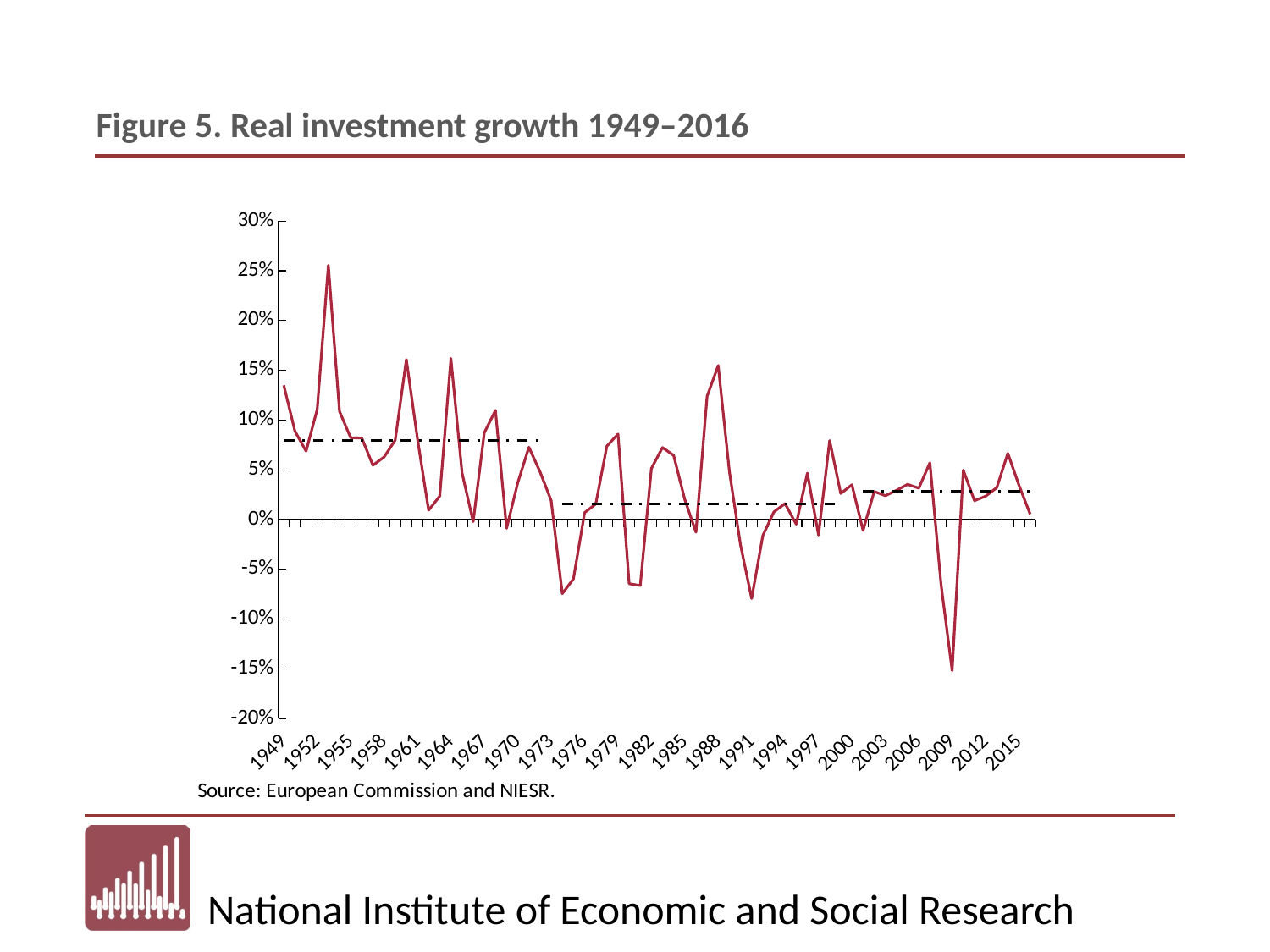
What is the title of the chart? Figure 5. Real investment growth 1949–2016 Do the dashed horizontal average lines step down or up as time moves from 1949 to 2016? down, then slightly up Is the value for 1991 greater or less than -5%? less Does the highest value on the line occur before or after 1960? before What kind of chart is shown on the slide? line chart Is the value for 2009 greater or less than -5%? less Is the value for 1949 greater or less than 10%? greater Does the lowest value on the line occur before or after 2000? after Which year has the larger value, 1949 or 2015? 1949 What source is cited beneath the chart? European Commission and NIESR